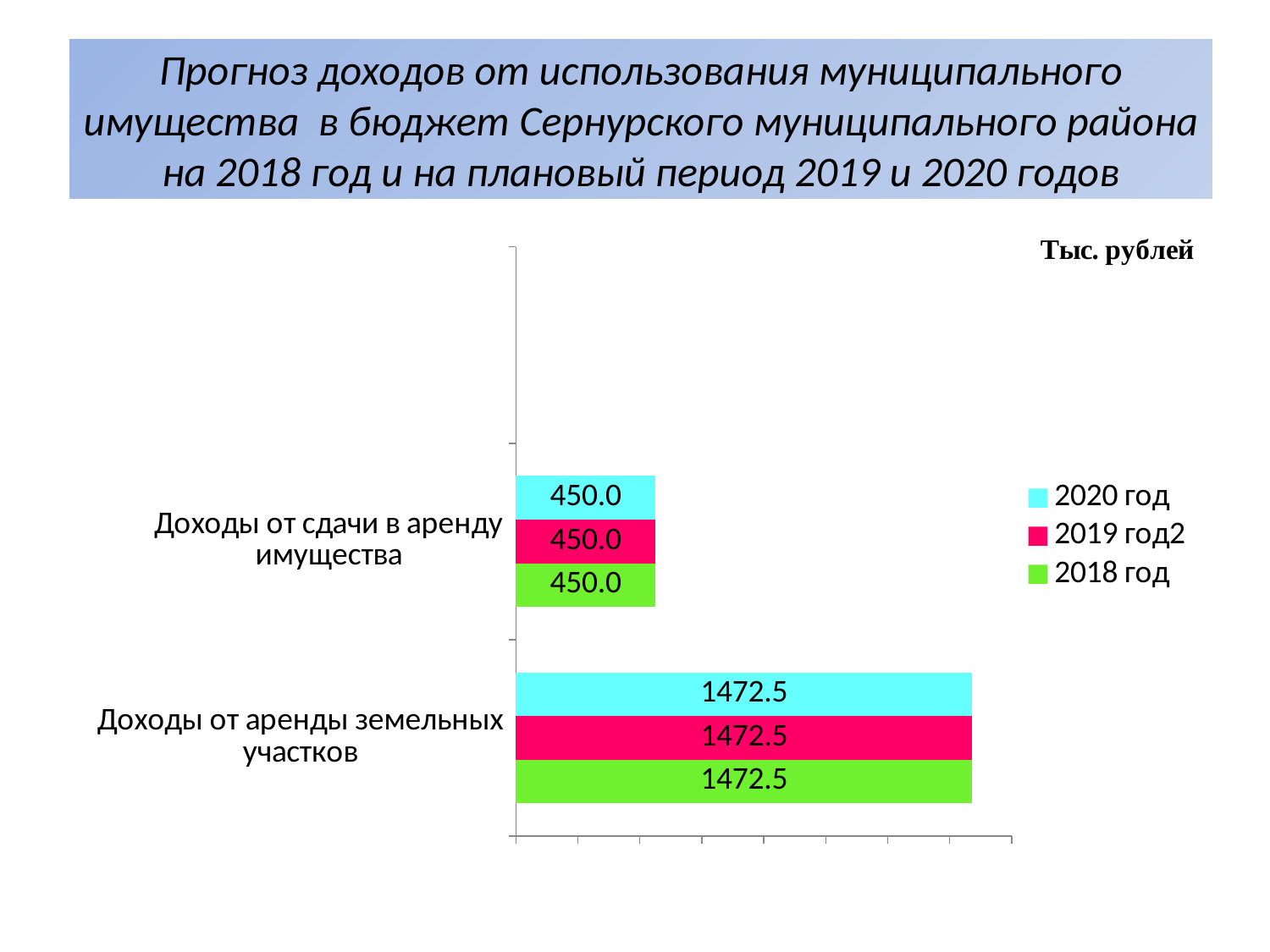
How many series does the legend list? 3 What is the value for "Доходы от сдачи в аренду имущества" in the 2018 год series? 450.0 What unit is indicated in the top right corner of the chart? Тыс. рублей What kind of chart is shown on the slide? bar chart What is the value for "Доходы от аренды земельных участков" in the 2019 год2 series? 1472.5 What is the difference between "Доходы от аренды земельных участков" and "Доходы от сдачи в аренду имущества" in the 2018 год series? 1022.5 Which category has the lowest value in the 2019 год2 series? Доходы от сдачи в аренду имущества How many categories are shown on the chart? 2 What is the value for "Доходы от сдачи в аренду имущества" in the 2020 год series? 450.0 Which is larger in the 2020 год series: "Доходы от аренды земельных участков" or "Доходы от сдачи в аренду имущества"? Доходы от аренды земельных участков Which category has the highest value in the 2020 год series? Доходы от аренды земельных участков What is the value for "Доходы от аренды земельных участков" in the 2018 год series? 1472.5